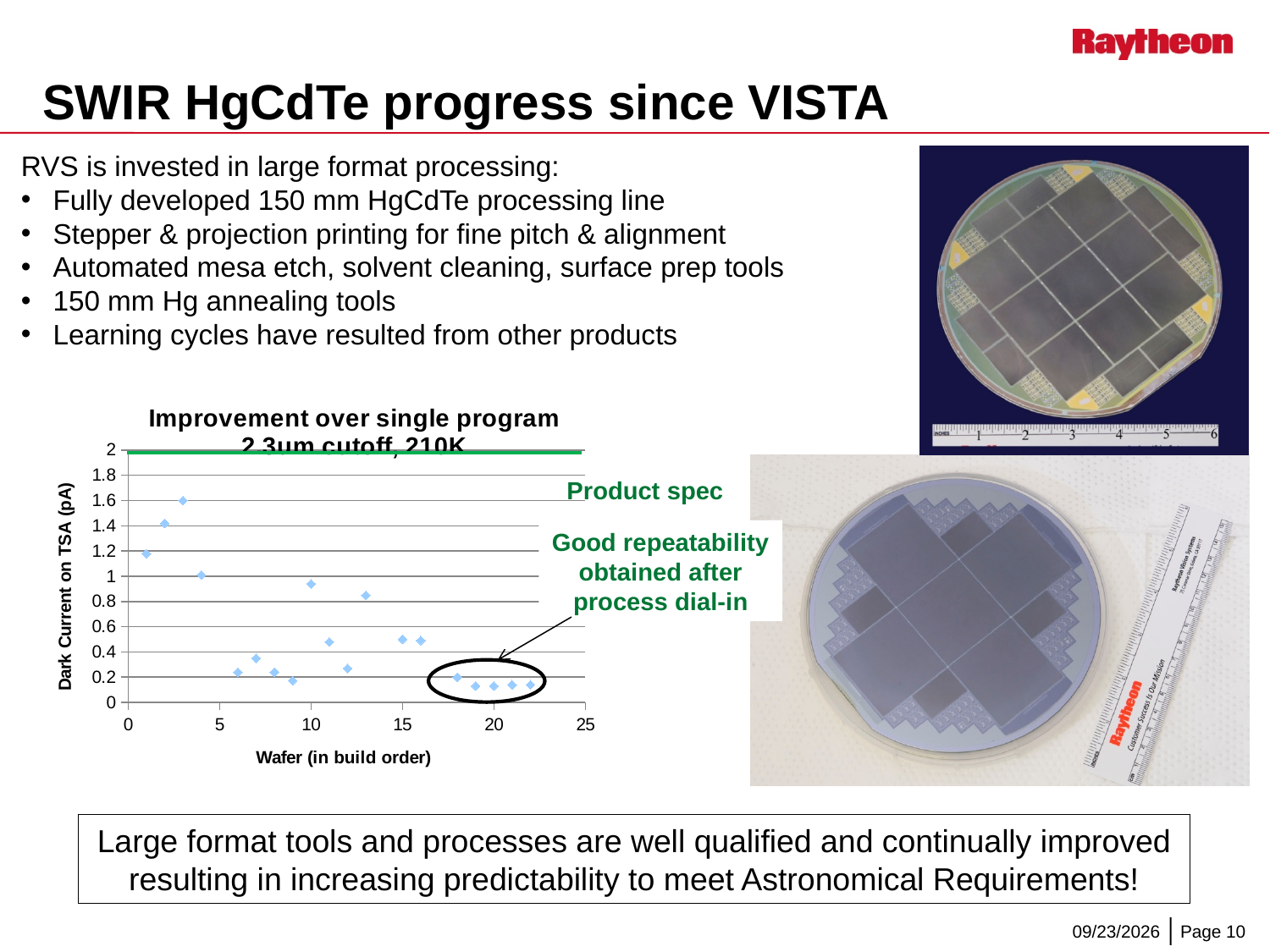
Is the dark current for wafer 1 greater or less than 1 pA? greater Is the dark current for wafer 20 greater or less than 0.2 pA? less What kind of chart is shown on the slide? scatter chart Is the dark current for wafer 10 greater or less than 1 pA? less Which wafer (in build order) has the highest dark current on the chart? Wafer 3 At what dark current value is the green 'Product spec' line drawn on the chart? 2 Which has the higher dark current, wafer 2 or wafer 4? Wafer 2 Overall, does the dark current rise or fall as the wafer build order increases? fall What is the label of the y axis of the chart? Dark Current on TSA (pA)